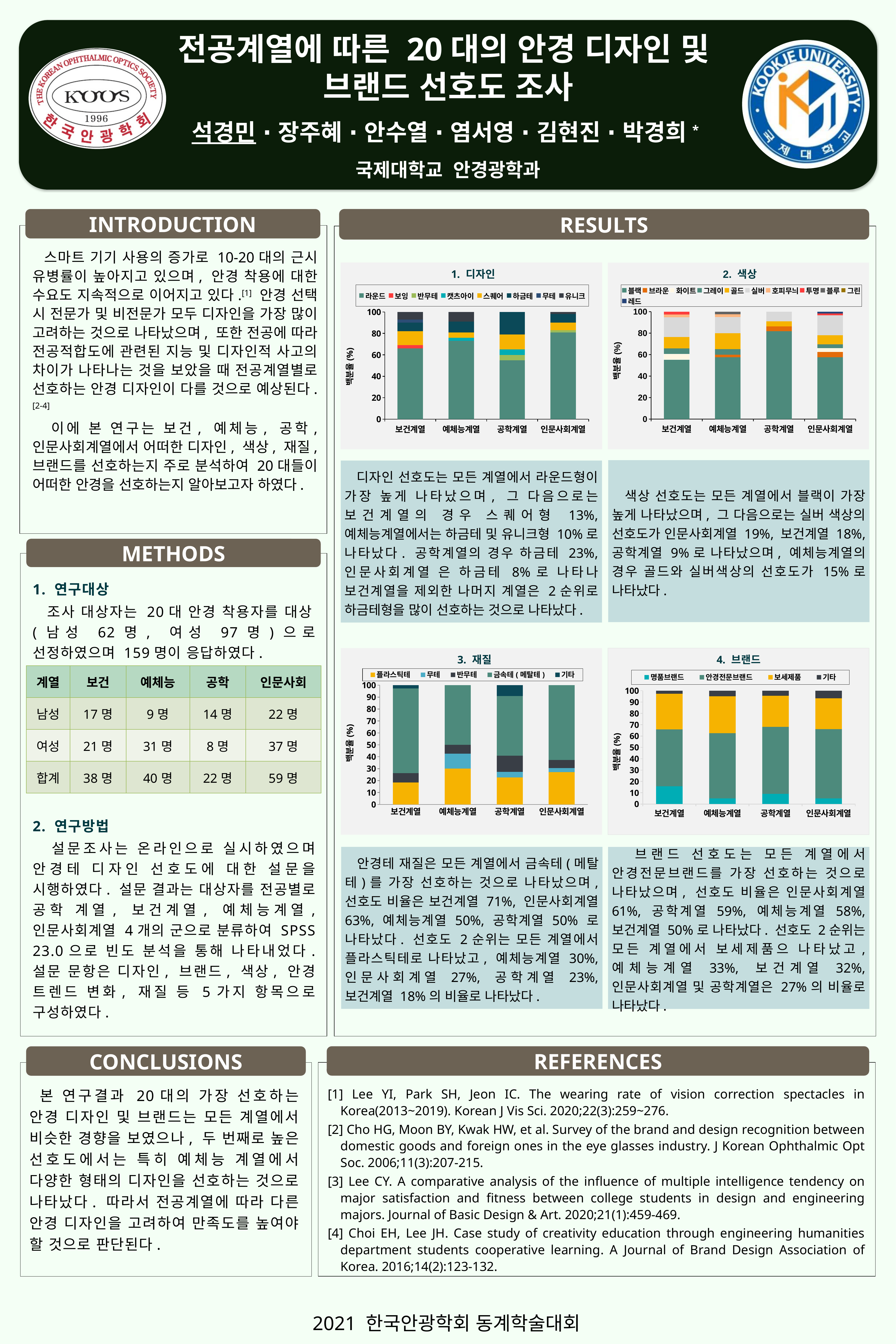
In the chart titled '2. 색상', how many series does the legend list? 11 In the chart titled '3. 재질', is the 플라스틱테 value for 예체능계열 greater or less than 20? greater In the chart titled '1. 디자인', is the 라운드 value for 인문사회계열 greater or less than 60? greater In the chart titled '1. 디자인', how many series does the legend list? 8 In the chart titled '2. 색상', is the 블랙 value for 공학계열 greater or less than 60? greater In the chart titled '4. 브랜드', which is larger, the 명품브랜드 value for 보건계열 or for 예체능계열? 보건계열 In the chart titled '2. 색상', which is larger, the 블랙 value for 공학계열 or for 보건계열? 공학계열 In the chart titled '4. 브랜드', what is the label of the y axis? 백분율 (%) In the chart titled '1. 디자인', which category has the largest 라운드 segment? 인문사회계열 In the chart titled '1. 디자인', how many categories are shown on the x axis? 4 In the chart titled '3. 재질', how many series does the legend list? 5 What kind of chart is the chart titled '1. 디자인'? stacked bar chart